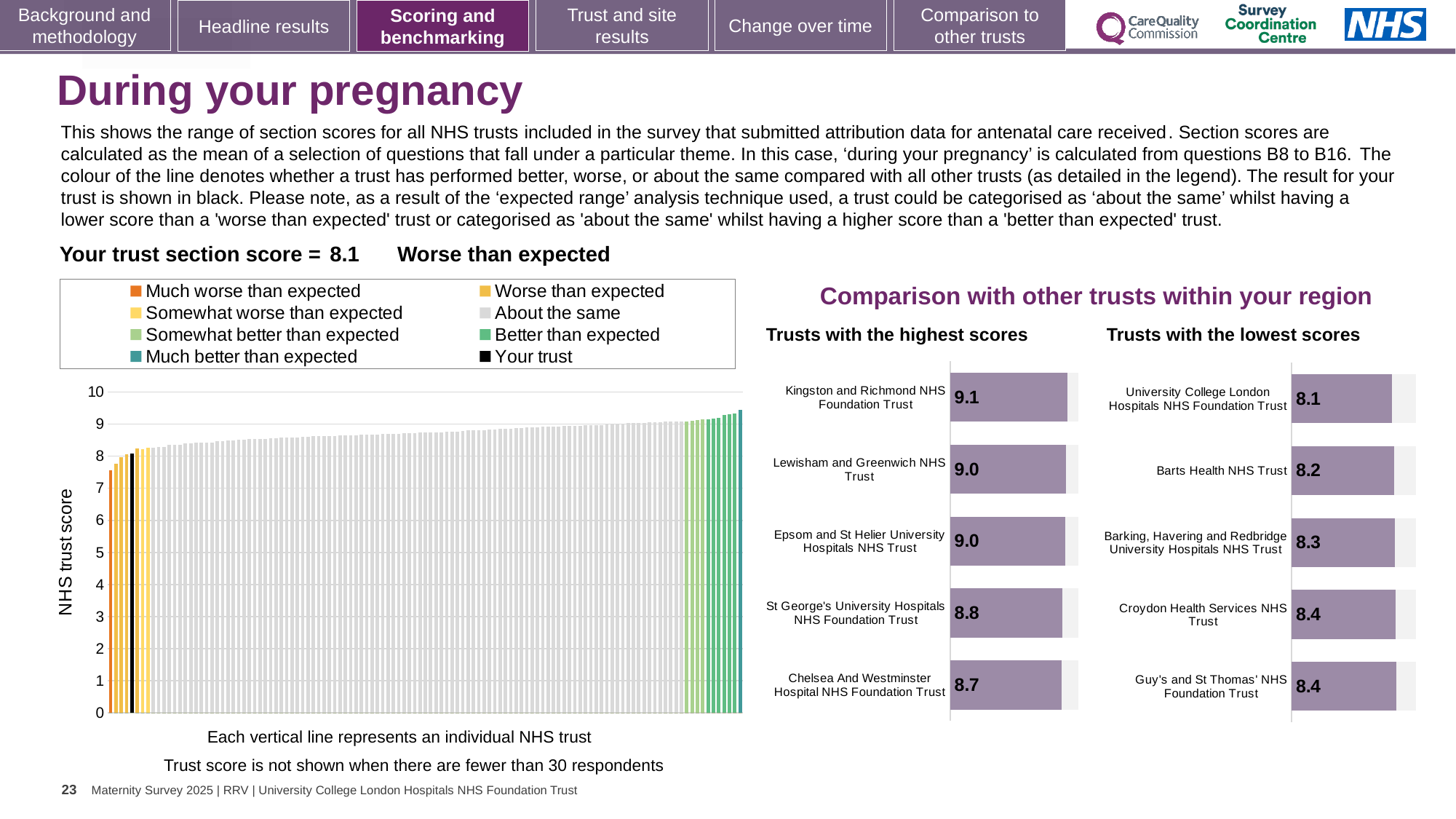
In the 'Trusts with the lowest scores' chart, which trust has the lowest score? University College London Hospitals NHS Foundation Trust In the main chart on the left showing all NHS trusts, do the scores rise or fall from left to right? Rise In the 'Trusts with the lowest scores' chart, what is the difference between the scores of Guy's and St Thomas' NHS Foundation Trust and University College London Hospitals NHS Foundation Trust? 0.3 In the 'Trusts with the highest scores' chart, what is the difference between the scores of Kingston and Richmond NHS Foundation Trust and Chelsea And Westminster Hospital NHS Foundation Trust? 0.4 In the 'Trusts with the highest scores' chart, which trust has the highest score? Kingston and Richmond NHS Foundation Trust In the main chart on the left showing all NHS trusts, what is the label on the vertical axis? NHS trust score In the 'Trusts with the lowest scores' chart, what is the score for Barts Health NHS Trust? 8.2 What kind of chart is the main chart on the left showing all NHS trusts? Bar chart In the 'Trusts with the highest scores' chart, how many trusts are shown? 5 In the 'Trusts with the lowest scores' chart, which has the higher score: Barts Health NHS Trust or Croydon Health Services NHS Trust? Croydon Health Services NHS Trust In the 'Trusts with the highest scores' chart, what is the score for Kingston and Richmond NHS Foundation Trust? 9.1 In the main chart on the left showing all NHS trusts, how many entries does the legend list? 8